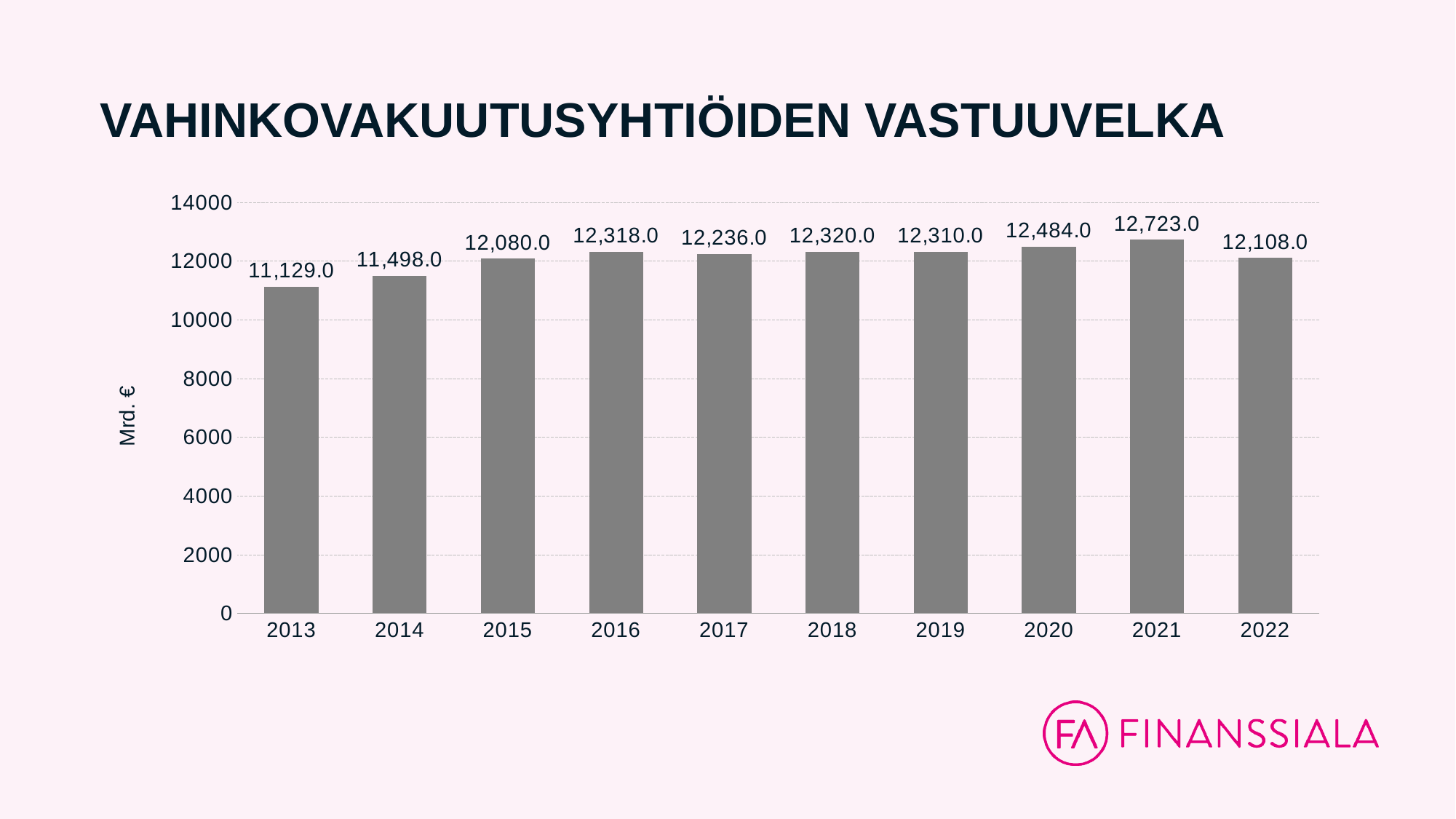
Which year has the highest value? 2021 What is the value for 2022? 12,108.0 What is the value for 2013? 11,129.0 What is the label on the y axis? Mrd. € How many years are shown on the x axis? 10 What kind of chart is shown on the slide? bar chart Is the value for 2014 greater or less than 12000? less Which is larger, the value for 2016 or the value for 2017? 2016 What is the value for 2021? 12,723.0 Which year has the lowest value? 2013 Do the values rise or fall from 2013 to 2016? rise What is the difference between the values for 2021 and 2022? 615.0